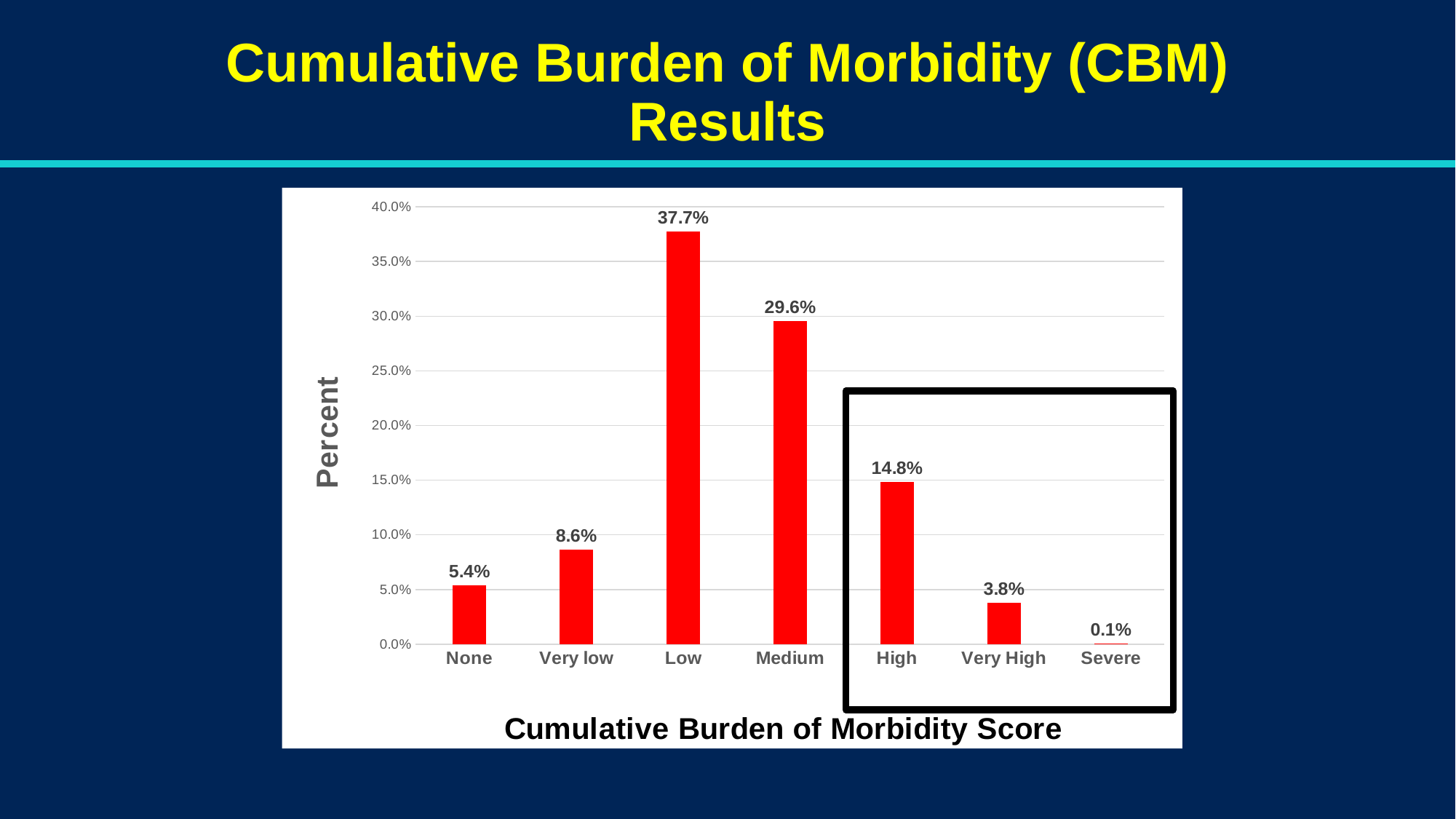
What is the difference between the values for High and Very High? 11.0% Which is larger, the value for Very low or the value for None? Very low Which category has the lowest value? Severe Is the value for Medium greater or less than 25.0%? greater How many categories are shown on the x axis? 7 What is the difference between the values for Low and Medium? 8.1% What is the value for the None category? 5.4% What is the value for the Very High category? 3.8% What kind of chart is shown on the slide? Bar chart What is the value for the Low category? 37.7% What is the label of the x axis? Cumulative Burden of Morbidity Score Which category has the highest value? Low